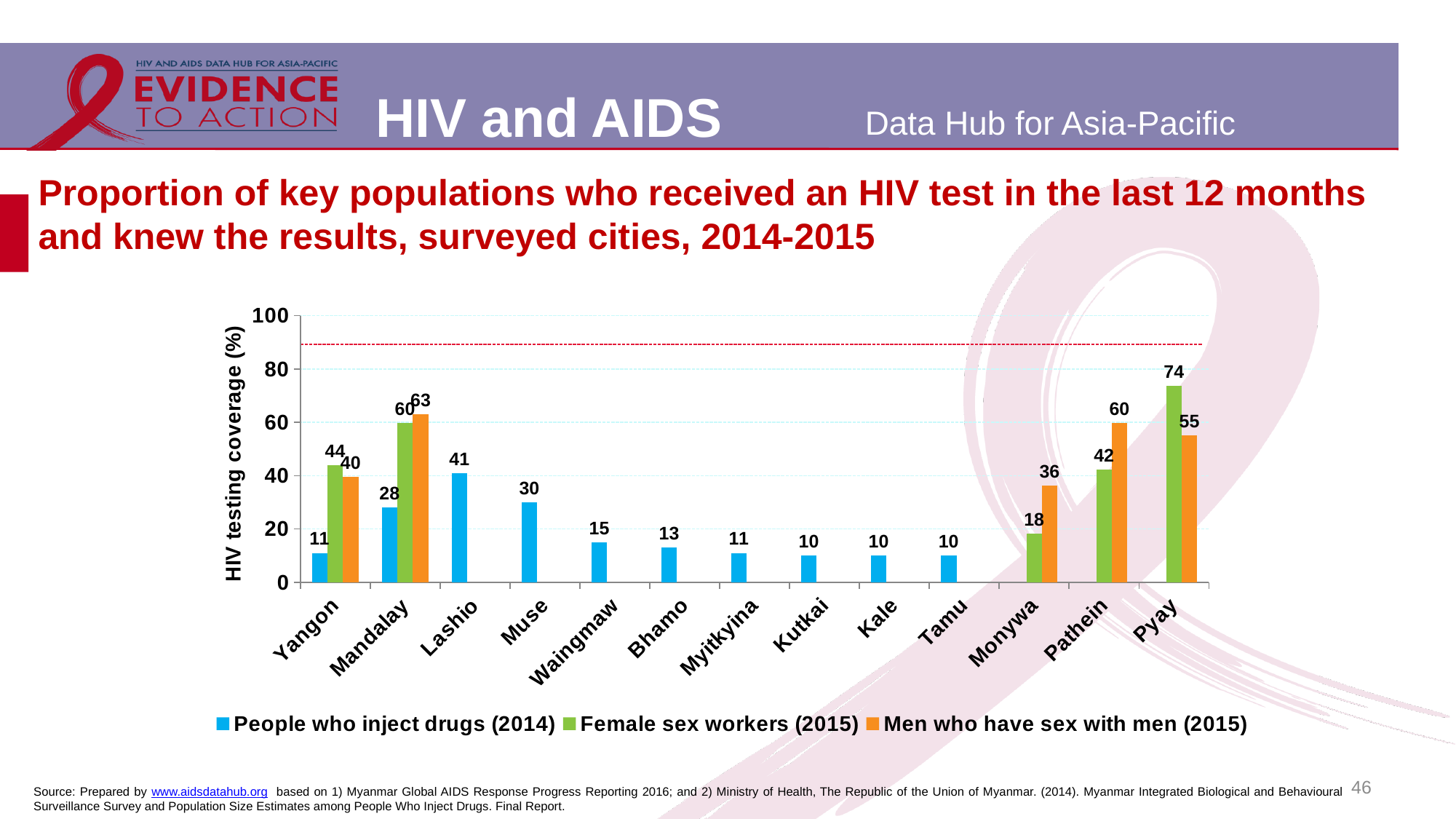
Which colour represents People who inject drugs (2014) in the legend? Blue What is the value for Men who have sex with men (2015) in Mandalay? 63 What is the label of the y axis? HIV testing coverage (%) What kind of chart is shown on the slide? Bar chart Which city has the highest value for People who inject drugs (2014)? Lashio What is the difference between the Men who have sex with men (2015) value in Pathein and in Monywa? 24 Which is larger in Yangon: the Female sex workers (2015) value or the Men who have sex with men (2015) value? Female sex workers (2015) What is the value for Female sex workers (2015) in Pyay? 74 What is the value for People who inject drugs (2014) in Lashio? 41 How many series does the legend list? 3 Which city has the lowest value for Female sex workers (2015)? Monywa How many cities are shown on the x axis? 13